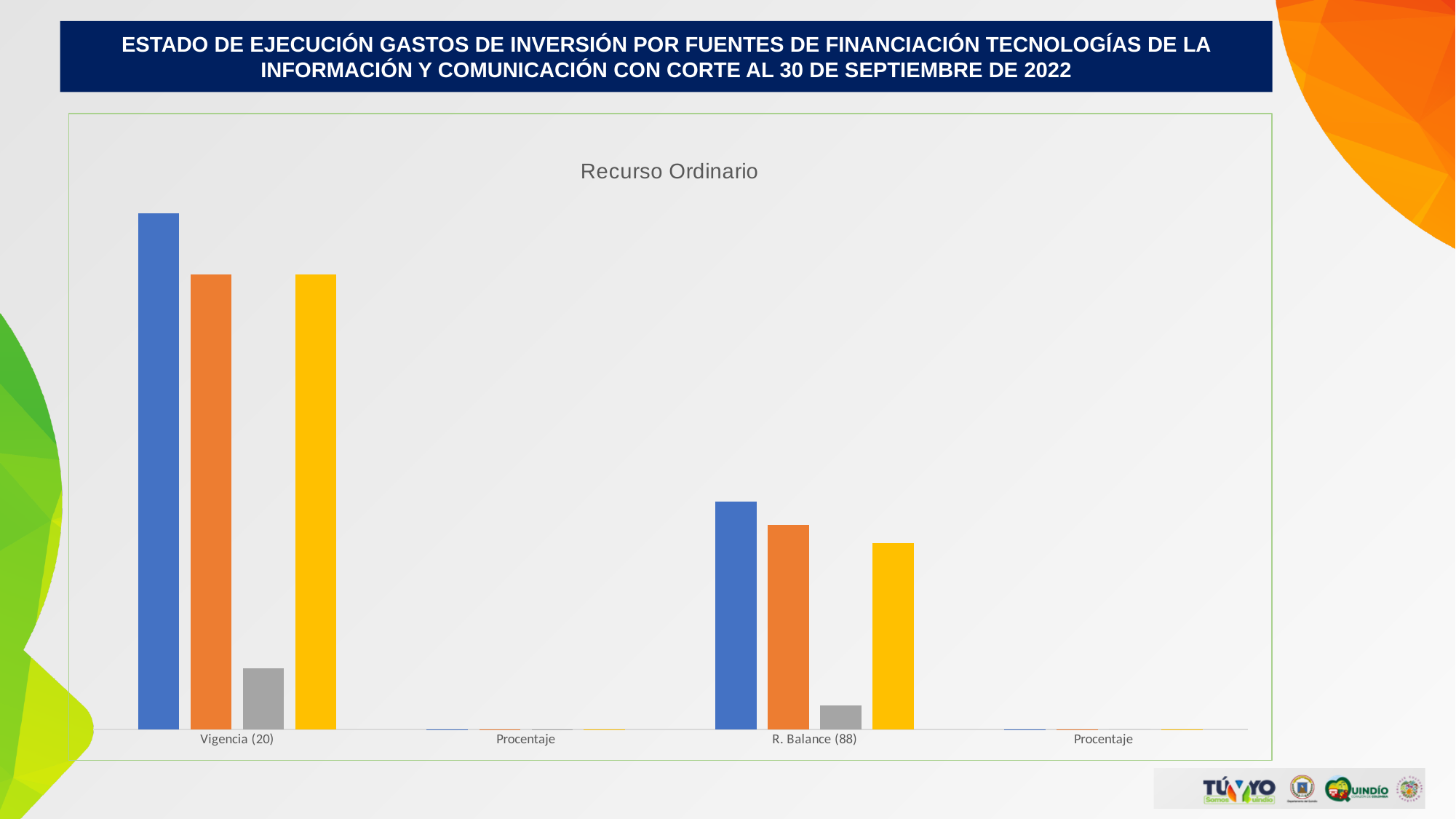
How many bars are plotted for the category Vigencia (20)? 4 What is the label of the third category on the x axis? R. Balance (88) Which category has the tallest bar in the chart? Vigencia (20) Which is larger, the blue bar for Vigencia (20) or the blue bar for R. Balance (88)? Vigencia (20) Within the category Vigencia (20), which coloured bar is the tallest? blue Which is larger, the orange bar or the gray bar for R. Balance (88)? orange Within the category R. Balance (88), which coloured bar is the tallest? blue Within the category Vigencia (20), which coloured bar is the shortest? gray Which is larger, the yellow bar for Vigencia (20) or the yellow bar for R. Balance (88)? Vigencia (20) What is the title of the chart? Recurso Ordinario What kind of chart is shown on the slide? bar chart How many categories are shown on the x axis of the chart? 4